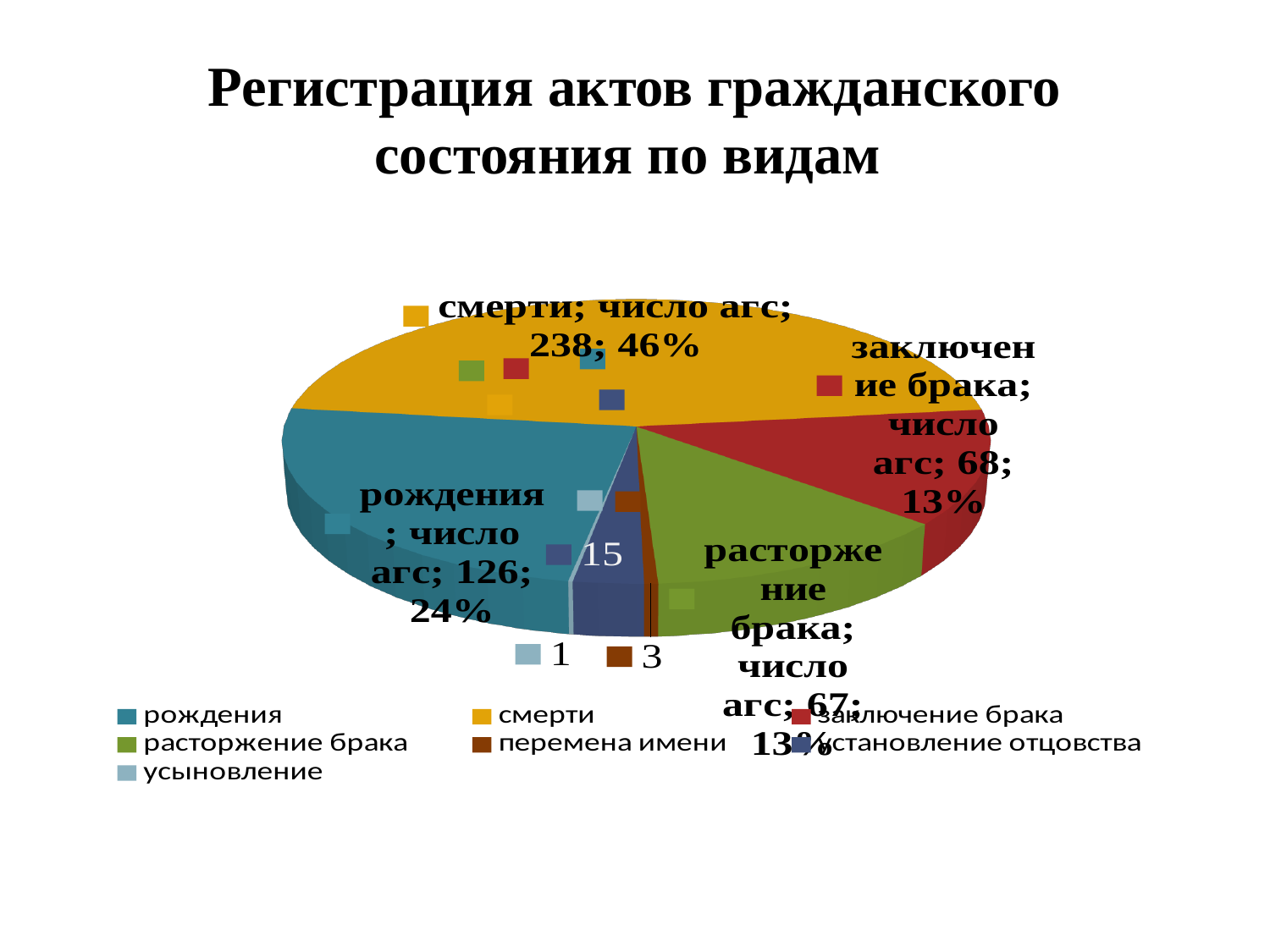
What kind of chart is shown on the slide? pie chart What is the number of civil status acts for рождения? 126 What share of the pie does рождения represent? 24% What is the number of civil status acts (число агс) for смерти? 238 Which category has the smallest slice of the pie? усыновление Which category has the largest slice of the pie? смерти What is the number of civil status acts for заключение брака? 68 How many categories does the legend list? 7 What share of the pie does смерти represent? 46% What value is shown for установление отцовства? 15 What is the difference between the number of acts for смерти and рождения? 112 What is the number of civil status acts for расторжение брака? 67